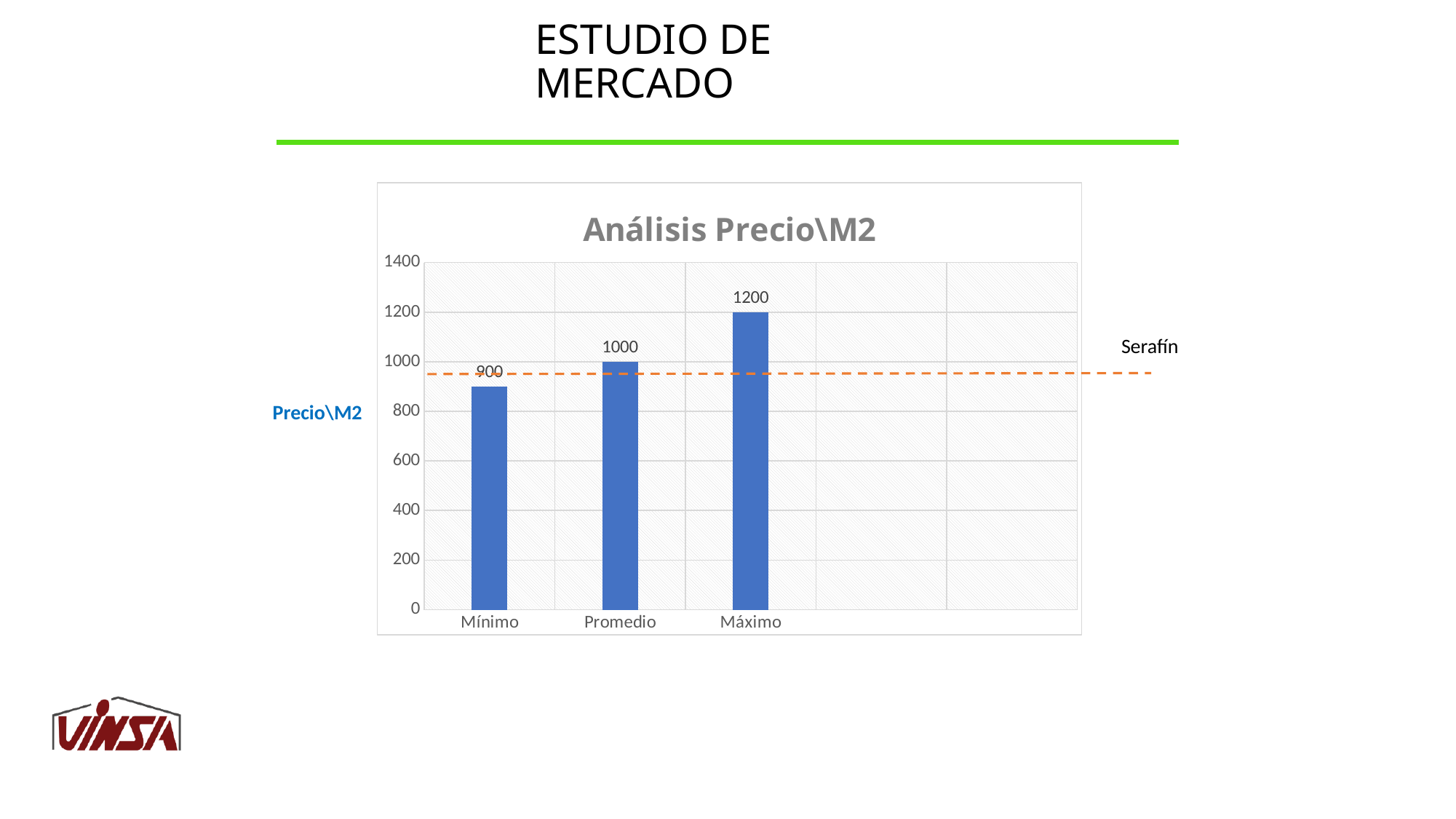
What kind of chart is shown? bar chart Which category has the highest value? Máximo Which category has the lowest value? Mínimo What is the title of the chart? Análisis Precio\M2 What is the difference between the values for Máximo and Mínimo? 300 What is the value for Máximo? 1200 What is the value for Mínimo? 900 What is the difference between the values for Promedio and Mínimo? 100 How many categories are shown on the x axis? 3 Is the value for Mínimo greater or less than 1000? less Which is larger, the value for Promedio or the value for Máximo? Máximo What is the value for Promedio? 1000